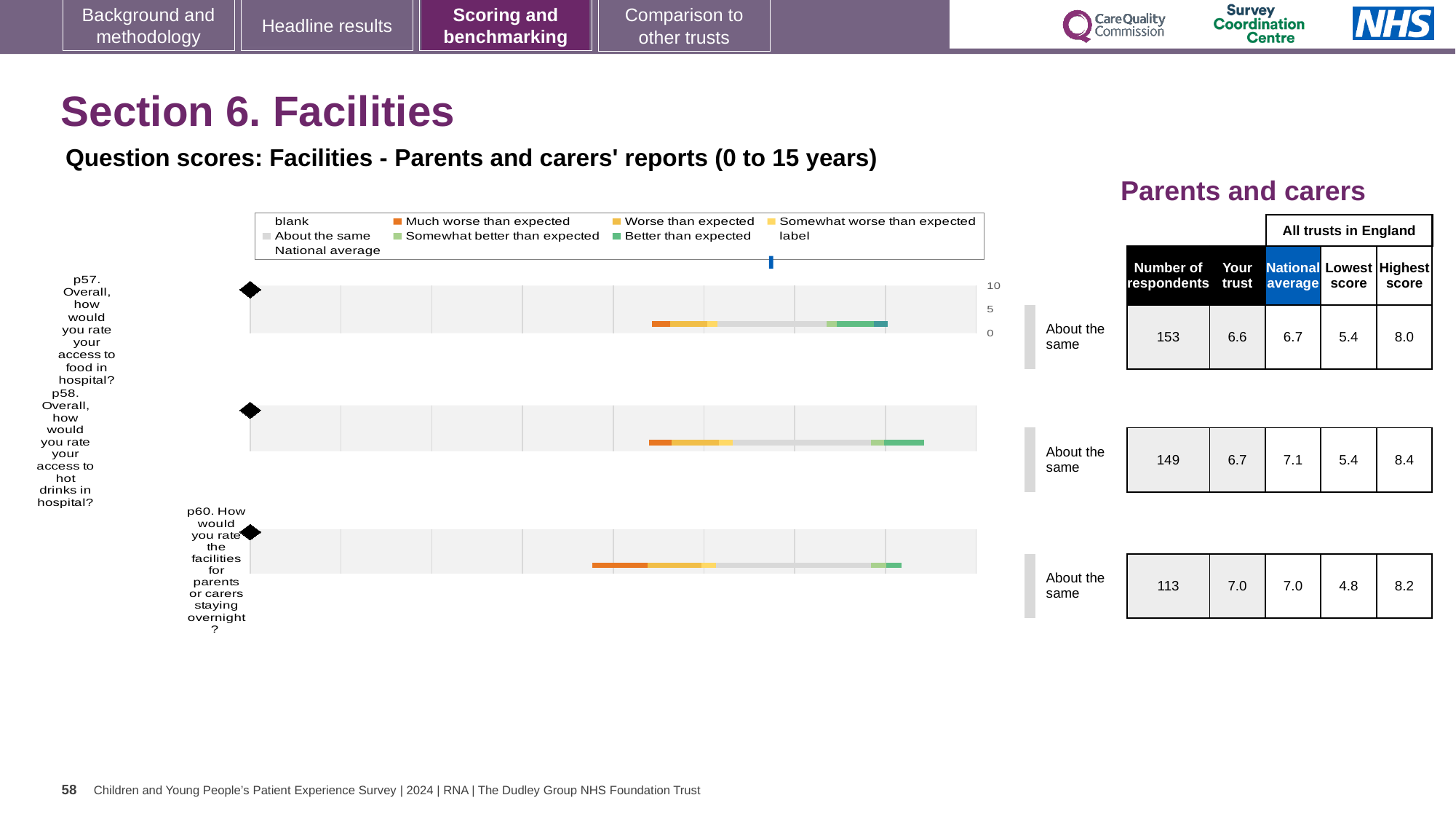
For p57 (access to food in hospital), what is the 'Your trust' score shown? 6.6 How many questions (charts) are shown on the slide? 3 Which question has the lowest 'Lowest score' across all trusts in England? p60 Which question has the highest 'Highest score' across all trusts in England? p58 For p57, which is larger: the 'Your trust' score or the national average? National average For p58 (access to hot drinks in hospital), what is the national average score shown? 7.1 For p60 (facilities for parents or carers staying overnight), how many respondents are shown? 113 For p58, what is the difference between the national average and the 'Your trust' score? 0.4 Is the 'Your trust' score for p60 greater or less than 5? greater What kind of chart is used to show the question scores for p57, p58 and p60? bar chart What colour does the legend use for 'Much worse than expected'? Orange What benchmark category is shown for all three questions? About the same